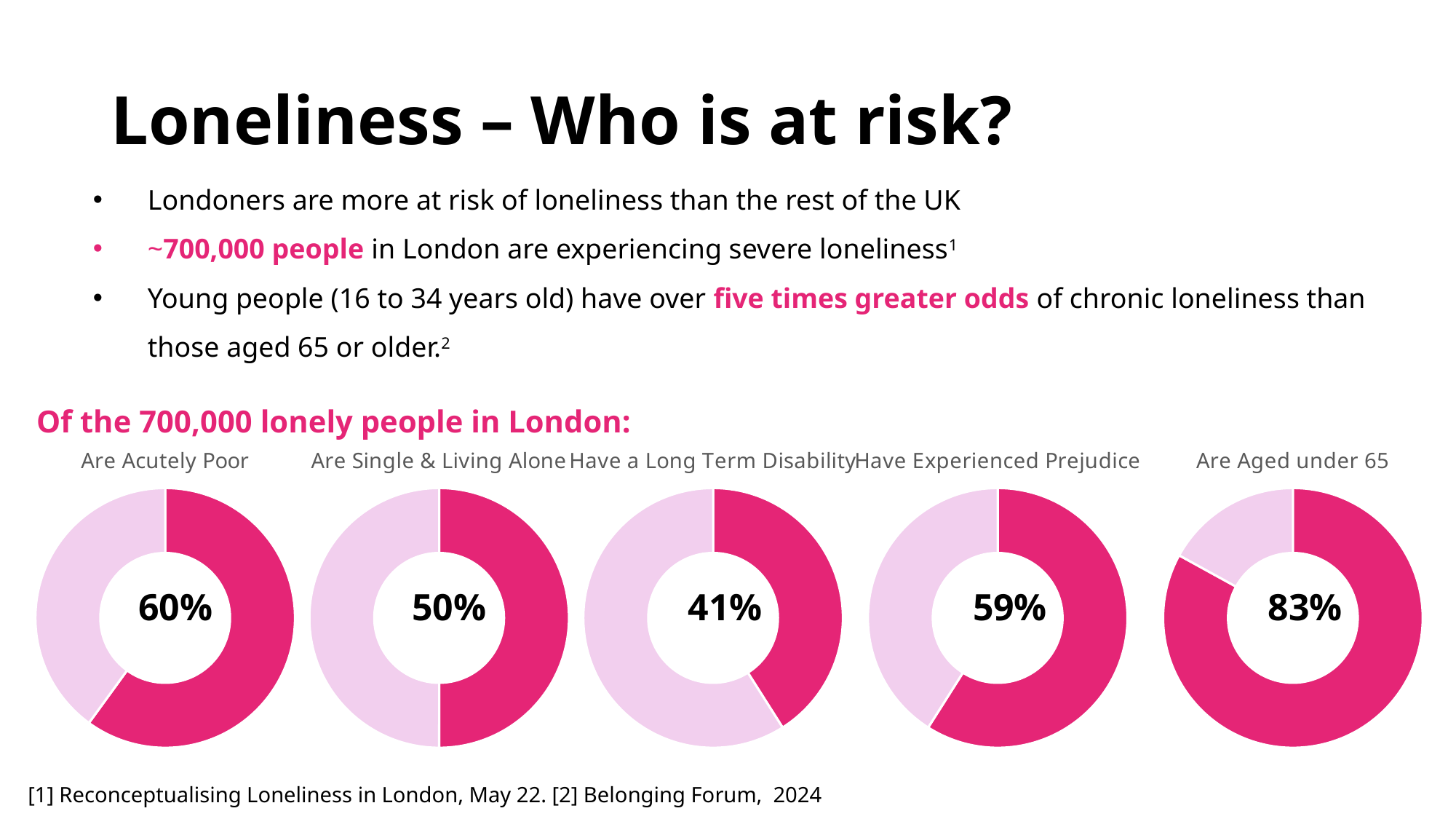
What is the heading printed above the row of donut charts? Of the 700,000 lonely people in London: Which of the five donut charts shows the highest percentage? Are Aged under 65 What value is shown in the 'Have Experienced Prejudice' chart? 59% Which of the five donut charts shows the lowest percentage? Have a Long Term Disability In the 'Are Single & Living Alone' chart, what value is shown? 50% How many donut charts are shown on the slide? 5 Which is larger: the value in the 'Are Acutely Poor' chart or the value in the 'Have Experienced Prejudice' chart? Are Acutely Poor What value is shown in the 'Have a Long Term Disability' chart? 41% What kind of chart is used to show the percentages on the slide? Donut chart What percentage of the 700,000 lonely people in London are acutely poor, according to the 'Are Acutely Poor' chart? 60% What value is shown in the 'Are Aged under 65' chart? 83% What is the difference between the value in the 'Are Aged under 65' chart and the value in the 'Have a Long Term Disability' chart? 42%